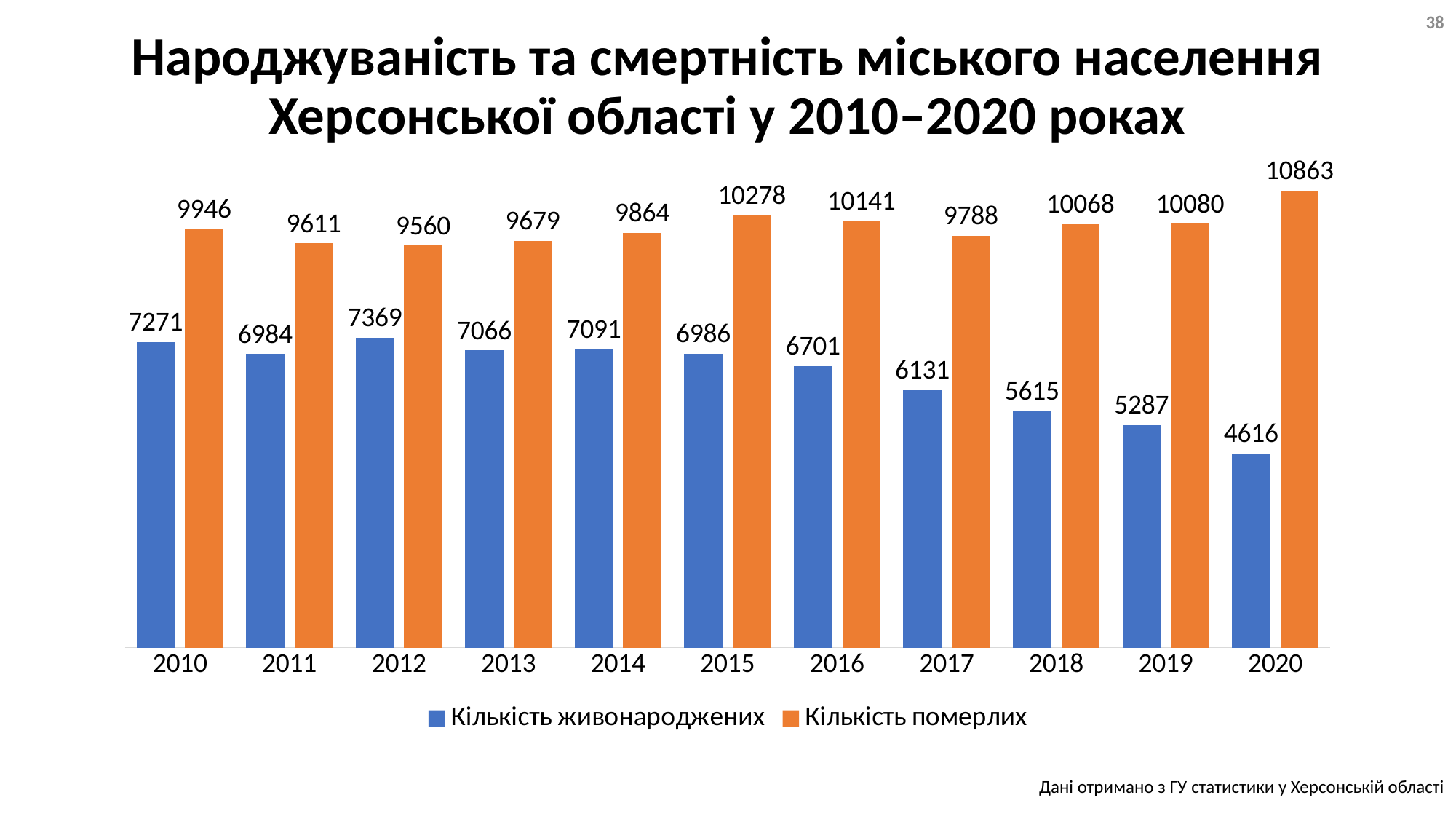
What kind of chart is shown on the slide? Bar chart What is the value of Кількість померлих for 2020? 10863 In which year is Кількість живонароджених the lowest? 2020 In which year is Кількість живонароджених the highest? 2012 What is the difference between Кількість померлих and Кількість живонароджених in 2020? 6247 What is the value of Кількість живонароджених for 2010? 7271 Which is larger in 2017: Кількість живонароджених or Кількість померлих? Кількість померлих How many series does the legend list? 2 Does Кількість живонароджених generally rise or fall from 2010 to 2020? Fall What is the value of Кількість померлих for 2015? 10278 How many years are shown on the x axis? 11 In which year is Кількість померлих the lowest? 2012